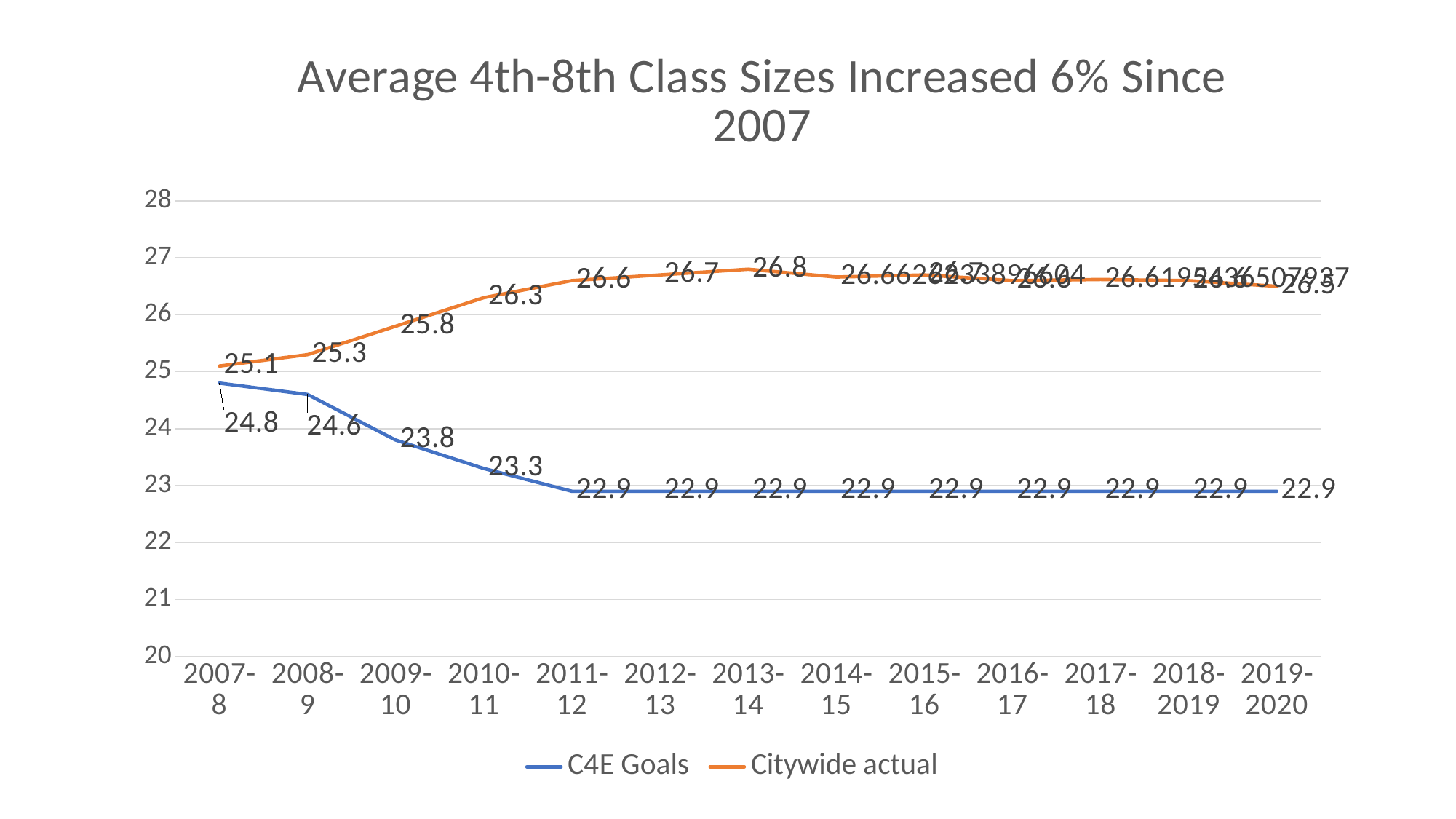
What is the lowest value reached by the C4E Goals series? 22.9 What is the difference between the C4E Goals values for 2007-8 and 2011-12? 1.9 What is the difference between the Citywide actual values for 2013-14 and 2007-8? 1.7 Does the C4E Goals series rise or fall from 2007-8 to 2011-12? fall What is the C4E Goals value for 2009-10? 23.8 What is the Citywide actual value for 2010-11? 26.3 What is the Citywide actual value for 2013-14? 26.8 What kind of chart is shown on the slide? line chart What is the C4E Goals value for 2007-8? 24.8 In 2009-10, which series has the higher value, C4E Goals or Citywide actual? Citywide actual How many series does the legend list? 2 How many school years are shown on the x axis? 13